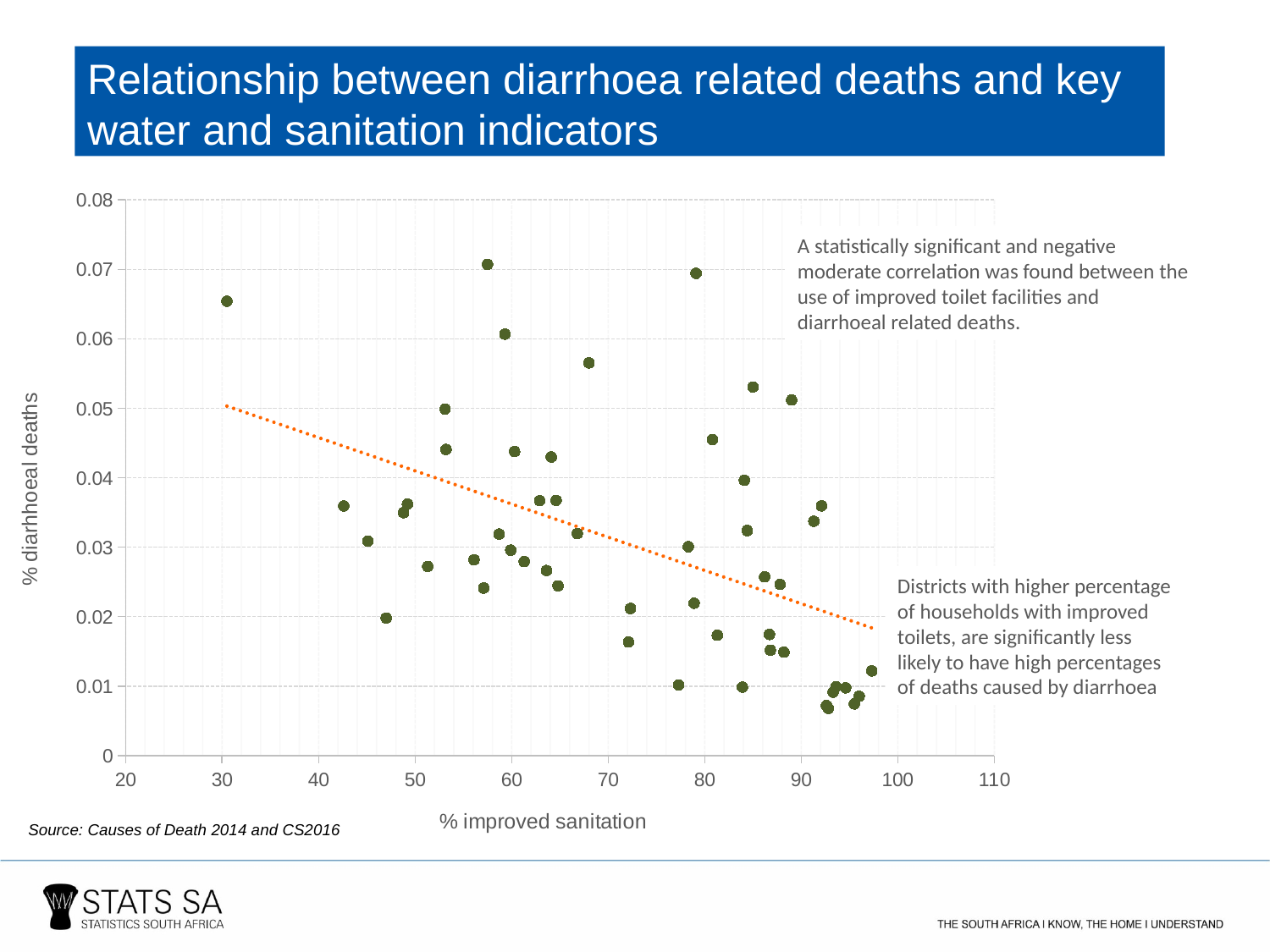
Is the trend line's value at 30% improved sanitation greater or less than 0.04? greater Is the trend line's value at 90% improved sanitation greater or less than 0.03? less What kind of chart is shown on the slide? Scatter chart Is the lowest point on the chart greater or less than 0.01 on the vertical axis? less What is the label of the horizontal axis? % improved sanitation What is the highest tick value shown on the horizontal axis? 110 What is the maximum value shown on the vertical axis? 0.08 According to the dotted trend line, do diarrhoeal deaths rise or fall as % improved sanitation increases? Fall